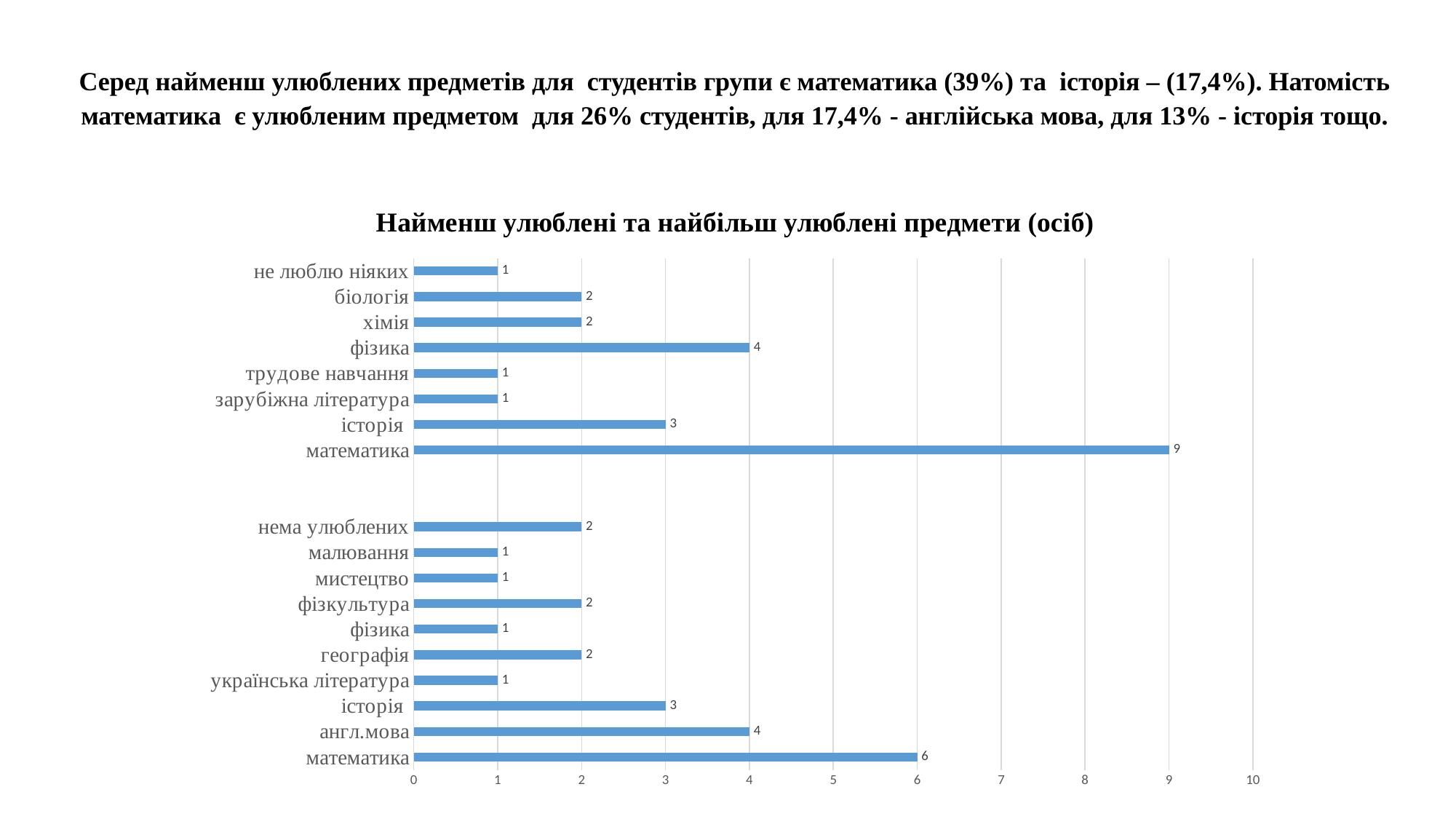
In the upper group of bars, what is the value for біологія? 2 What is the title of the chart? Найменш улюблені та найбільш улюблені предмети (осіб) In the lower group of bars, which is larger: the value for англ.мова or the value for історія? англ.мова Which category has the highest value in the whole chart? математика In the upper group of bars, what is the value for фізика? 4 What type of chart is shown on the slide? bar chart How many bars are plotted in the chart in total? 18 In the lower group of bars, which category has the highest value? математика In the lower group of bars, what is the value for математика? 6 In the upper group of bars, what is the value for математика? 9 In the lower group of bars, what is the value for англ.мова? 4 What is the difference between the value for математика in the upper group and the value for математика in the lower group? 3